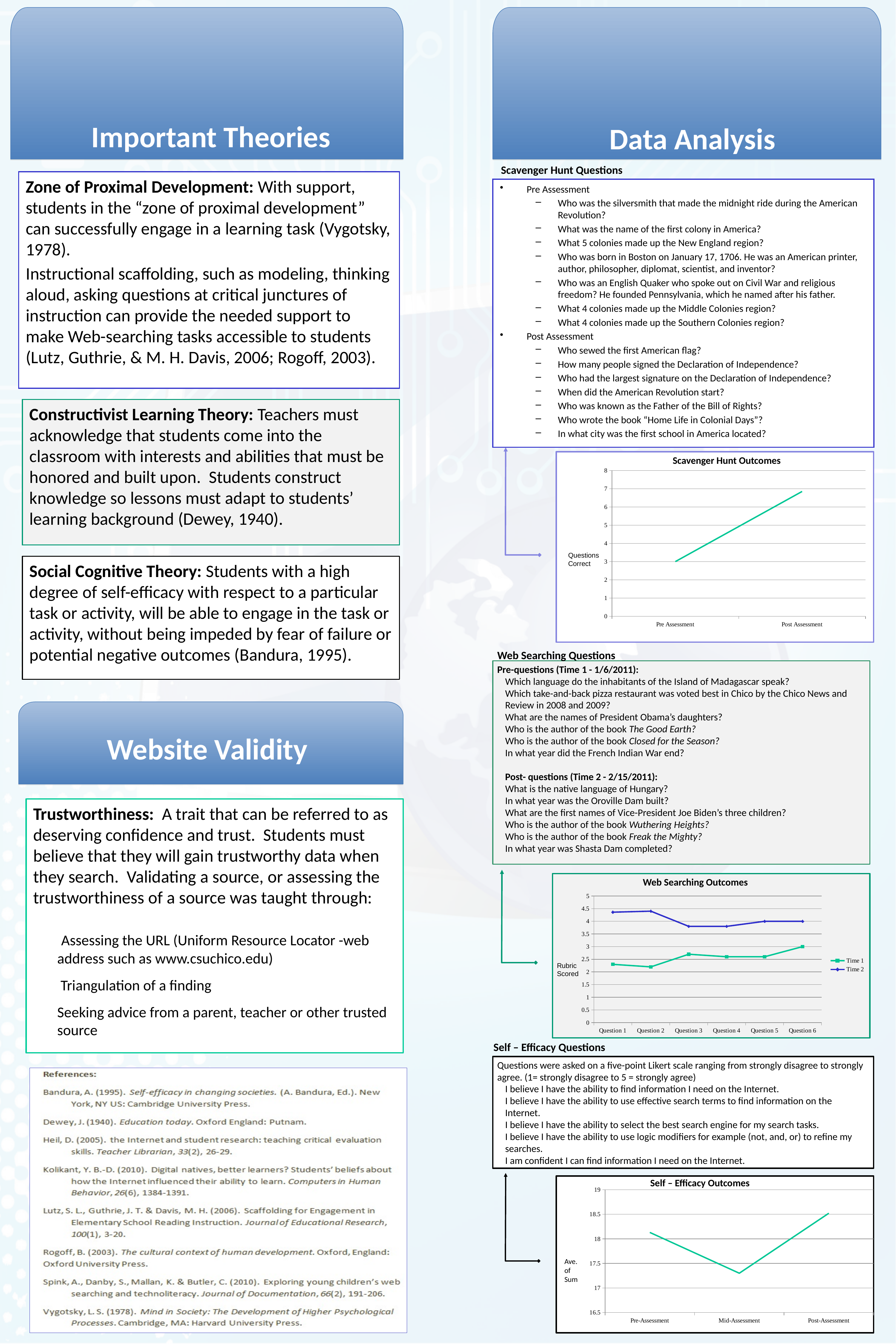
In the Scavenger Hunt Outcomes chart, is the value for Pre Assessment greater or less than 4? less How many series does the legend of the Web Searching Outcomes chart list? 2 How many questions are plotted along the x axis of the Web Searching Outcomes chart? 6 What kind of chart is the Scavenger Hunt Outcomes chart? line chart In the Web Searching Outcomes chart, is the Time 2 value for Question 1 greater or less than 4? greater In the Scavenger Hunt Outcomes chart, is the value for Post Assessment greater or less than 6? greater In the Self – Efficacy Outcomes chart, which assessment has the lowest value? Mid-Assessment In the Scavenger Hunt Outcomes chart, do the values rise or fall from Pre Assessment to Post Assessment? rise In the Web Searching Outcomes chart, which series is higher at Question 1, Time 1 or Time 2? Time 2 What is the y-axis label of the Web Searching Outcomes chart? Rubric Scored In the Web Searching Outcomes chart, at which question is the Time 1 series highest? Question 6